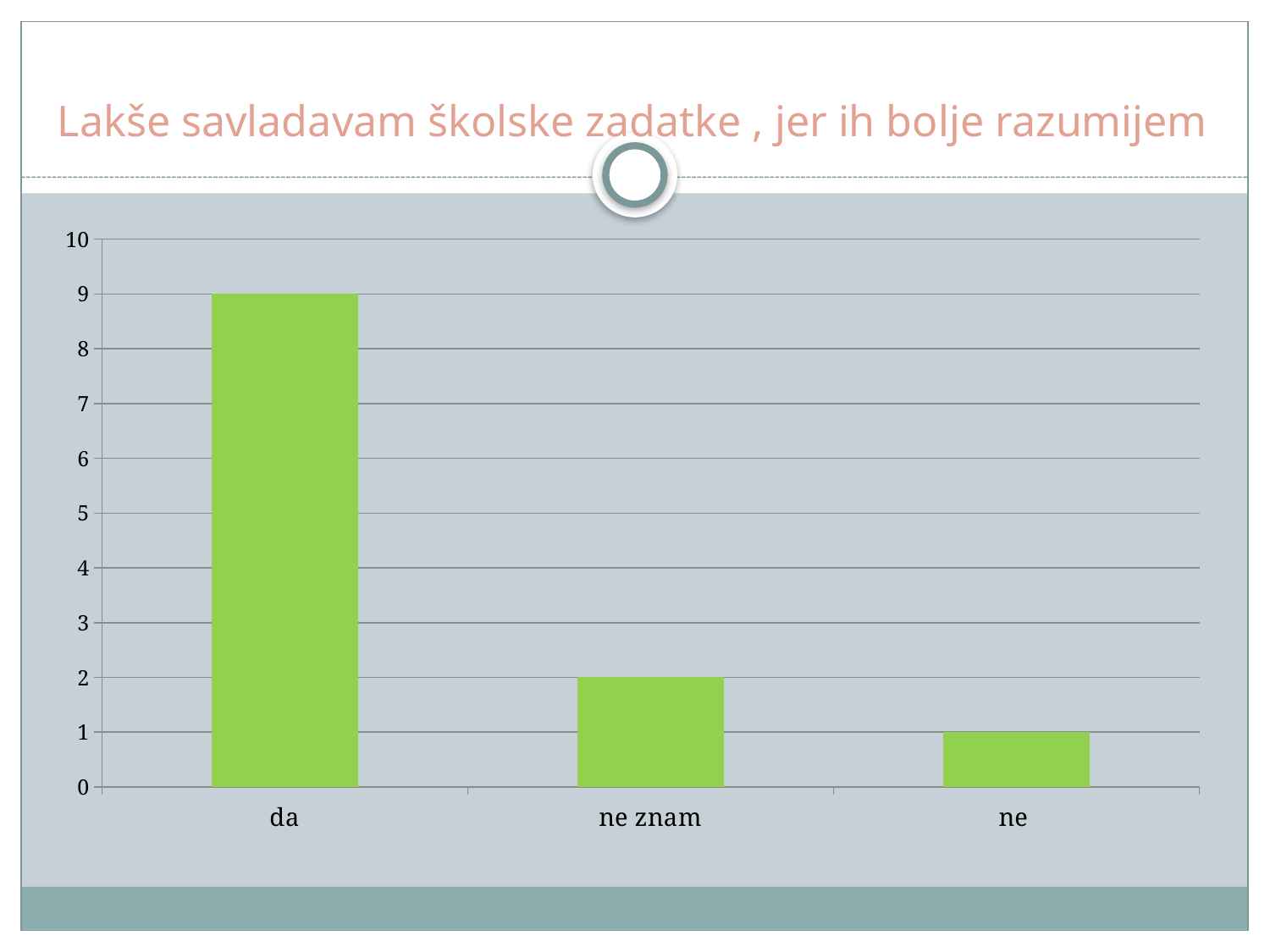
What is the difference between the values for "ne znam" and "ne"? 1 What kind of chart is shown on the slide? bar chart Which category has the highest value? da What is the value for "ne"? 1 Which category has the lowest value? ne Is the value for "da" greater or less than 5? greater Which is larger, the value for "ne znam" or the value for "ne"? ne znam How many categories are shown on the x axis? 3 What is the value for "ne znam"? 2 Do the values rise or fall from left to right along the x axis? fall What is the difference between the values for "da" and "ne znam"? 7 What is the value for "da"? 9